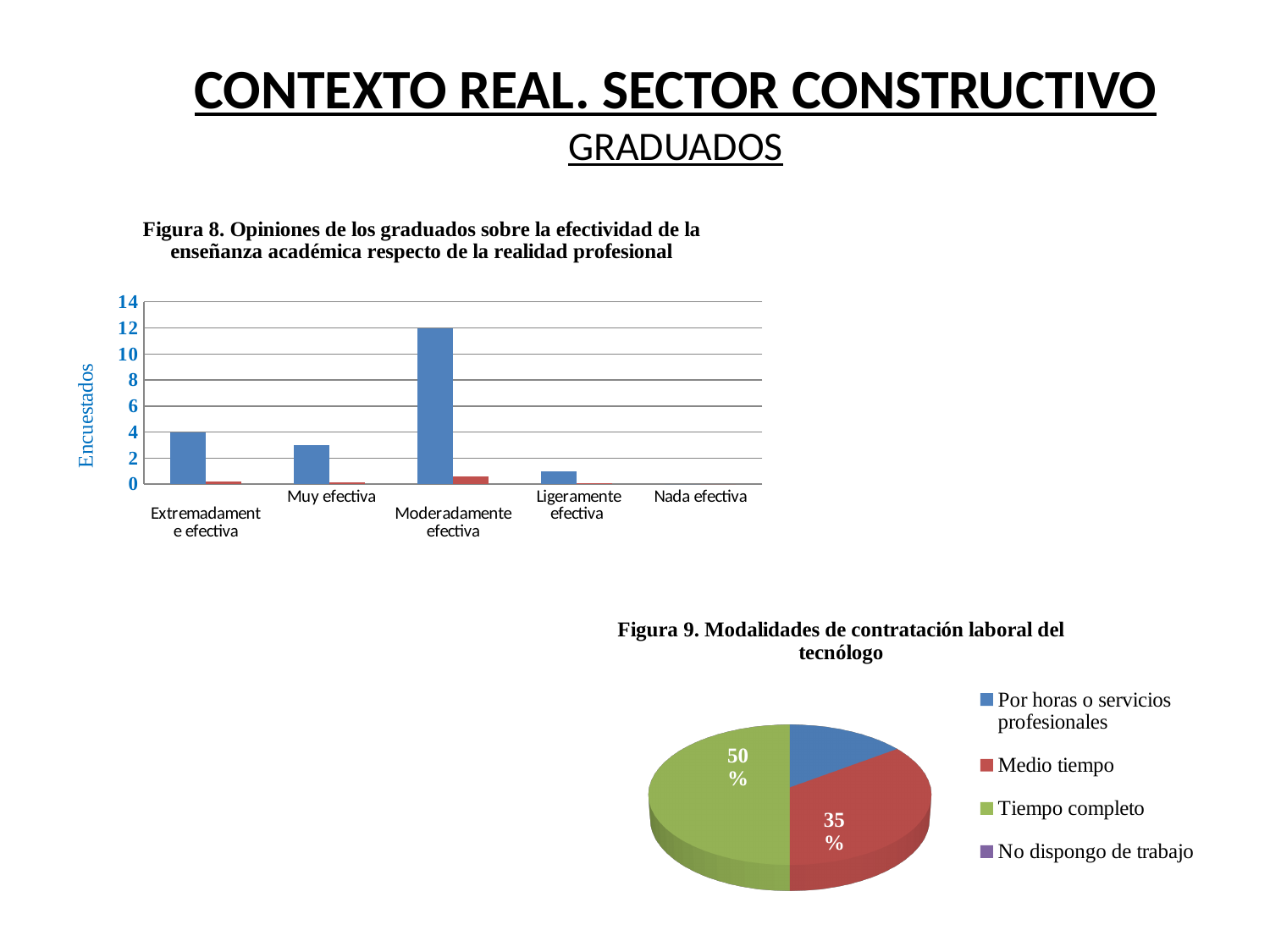
In Figura 8, how many categories are shown on the x axis? 5 In Figura 8, is the value for Muy efectiva greater or less than 4? less In Figura 9, what share of the pie is Medio tiempo? 35% In Figura 9, what share of the pie is Tiempo completo? 50% In Figura 8, which category has the highest number of encuestados? Moderadamente efectiva What kind of chart is Figura 9? pie chart In Figura 9, how many entries does the legend list? 4 In Figura 8, how many encuestados chose Extremadamente efectiva? 4 In Figura 8, which is larger: the value for Extremadamente efectiva or for Muy efectiva? Extremadamente efectiva What kind of chart is Figura 8? bar chart In Figura 8, how many encuestados chose Moderadamente efectiva? 12 In Figura 8, what is the difference between the values for Moderadamente efectiva and Extremadamente efectiva? 8